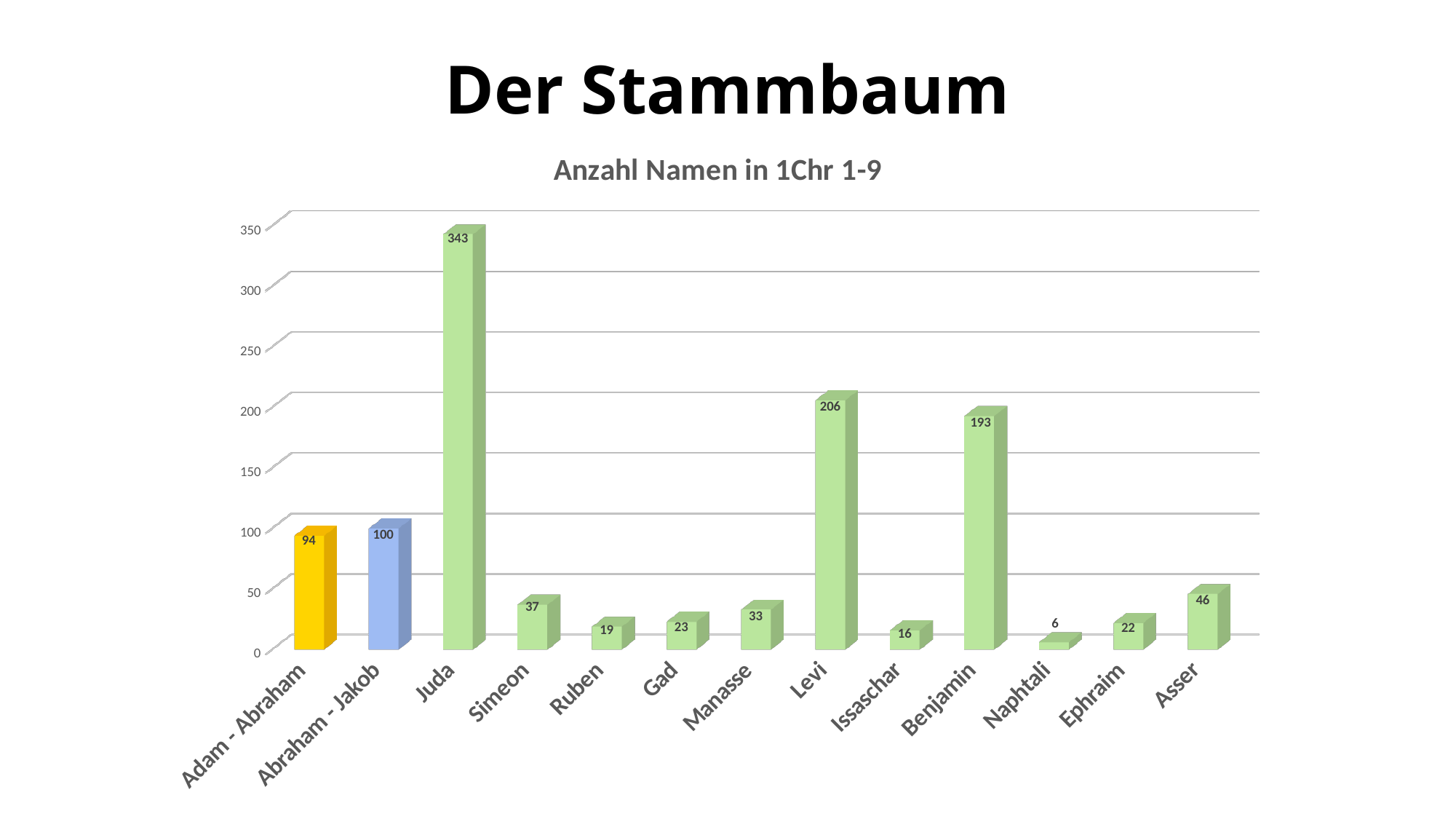
What is the value for Levi? 206 What is the difference between the values for Levi and Benjamin? 13 Which category has the highest value? Juda What is the value for Naphtali? 6 How many categories are shown on the x axis? 13 What is the title of the chart? Anzahl Namen in 1Chr 1-9 Is the value for Benjamin greater or less than 150? greater Which is larger, the value for Asser or the value for Simeon? Asser What kind of chart is shown? bar chart Which category has the lowest value? Naphtali What is the value for Juda? 343 What is the value for Abraham - Jakob? 100